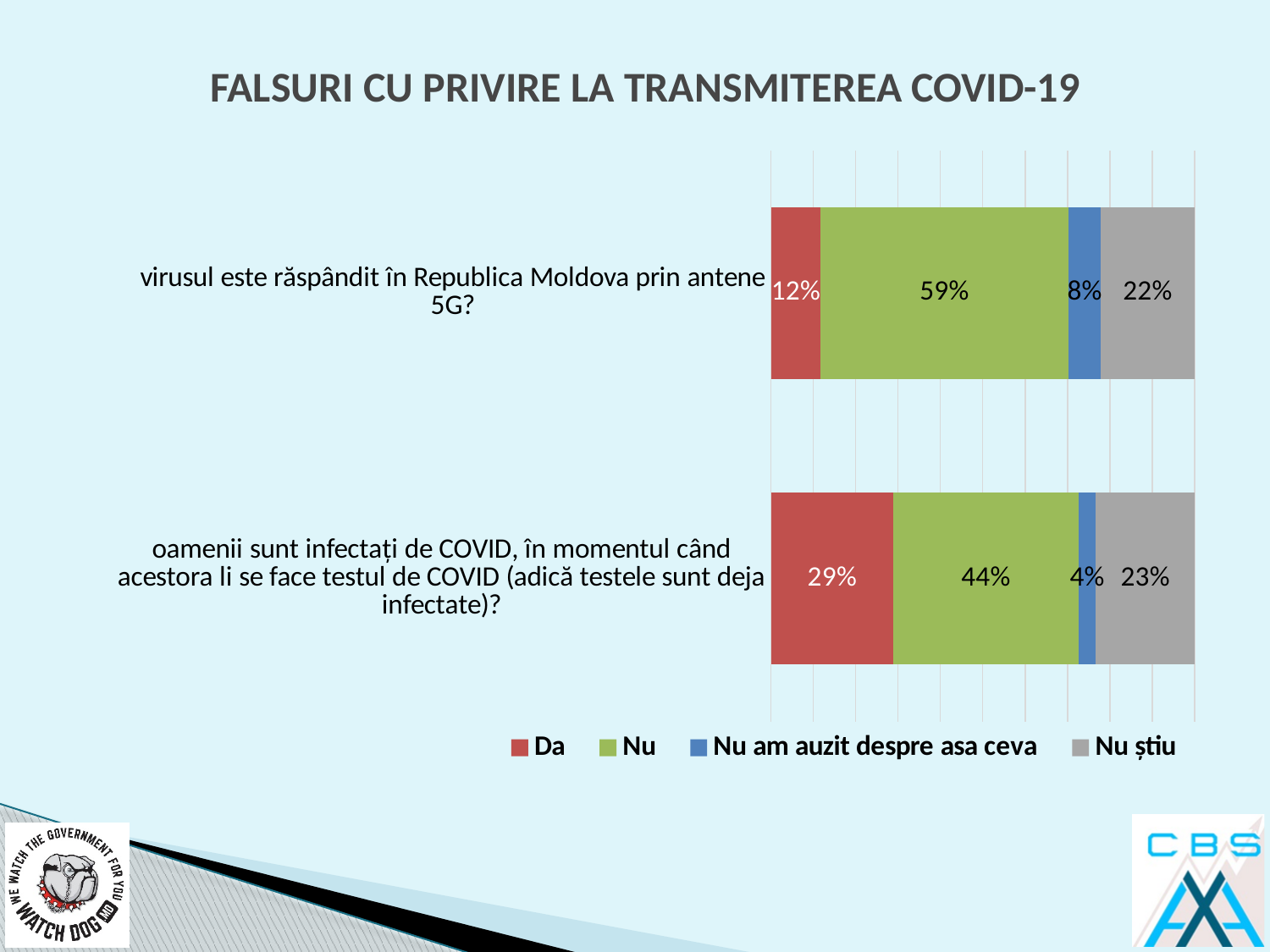
How many series does the legend list? 4 Which statement has a larger "Nu" share: the 5G antennas statement or the COVID test statement? The 5G antennas statement What is the difference between the "Da" share for the COVID test statement and the "Da" share for the 5G antennas statement? 17% What kind of chart is shown on the slide? Stacked bar chart How many categories (questions) are plotted in the chart? 2 What percentage answered "Da" to the statement that the virus is spread in the Republic of Moldova through 5G antennas? 12% What colour represents the "Nu știu" series in the chart? Grey What percentage answered "Nu am auzit despre asa ceva" to the statement that people are infected with COVID when they are tested? 4% Which response has the largest share for the statement about 5G antennas? Nu Which response has the smallest share for the statement about COVID tests being already infected? Nu am auzit despre asa ceva What percentage answered "Nu" to the statement that the virus is spread through 5G antennas? 59% What percentage answered "Nu știu" to the statement that people are infected with COVID when they are tested? 23%